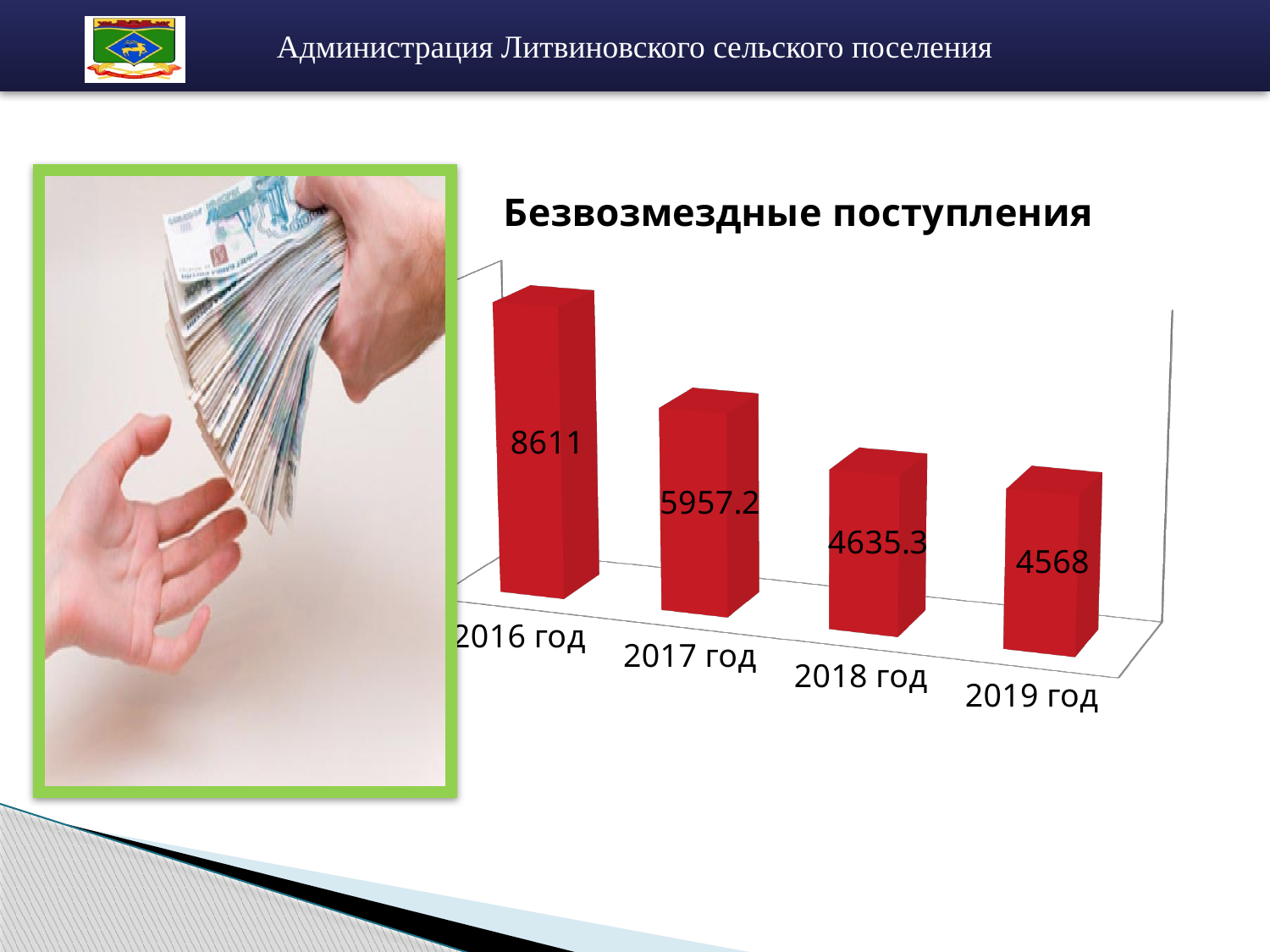
What is the difference between the values for 2016 год and 2017 год? 2653.8 Which year has the highest value? 2016 год Which year has the lowest value? 2019 год What is the value for 2018 год? 4635.3 What is the value for 2019 год? 4568 What is the value for 2017 год? 5957.2 Which is larger, the value for 2017 год or the value for 2018 год? 2017 год Do the values rise or fall from 2016 год to 2019 год? fall What is the difference between the values for 2018 год and 2019 год? 67.3 How many years are shown in the chart? 4 What is the value for 2016 год? 8611 What kind of chart is shown? bar chart